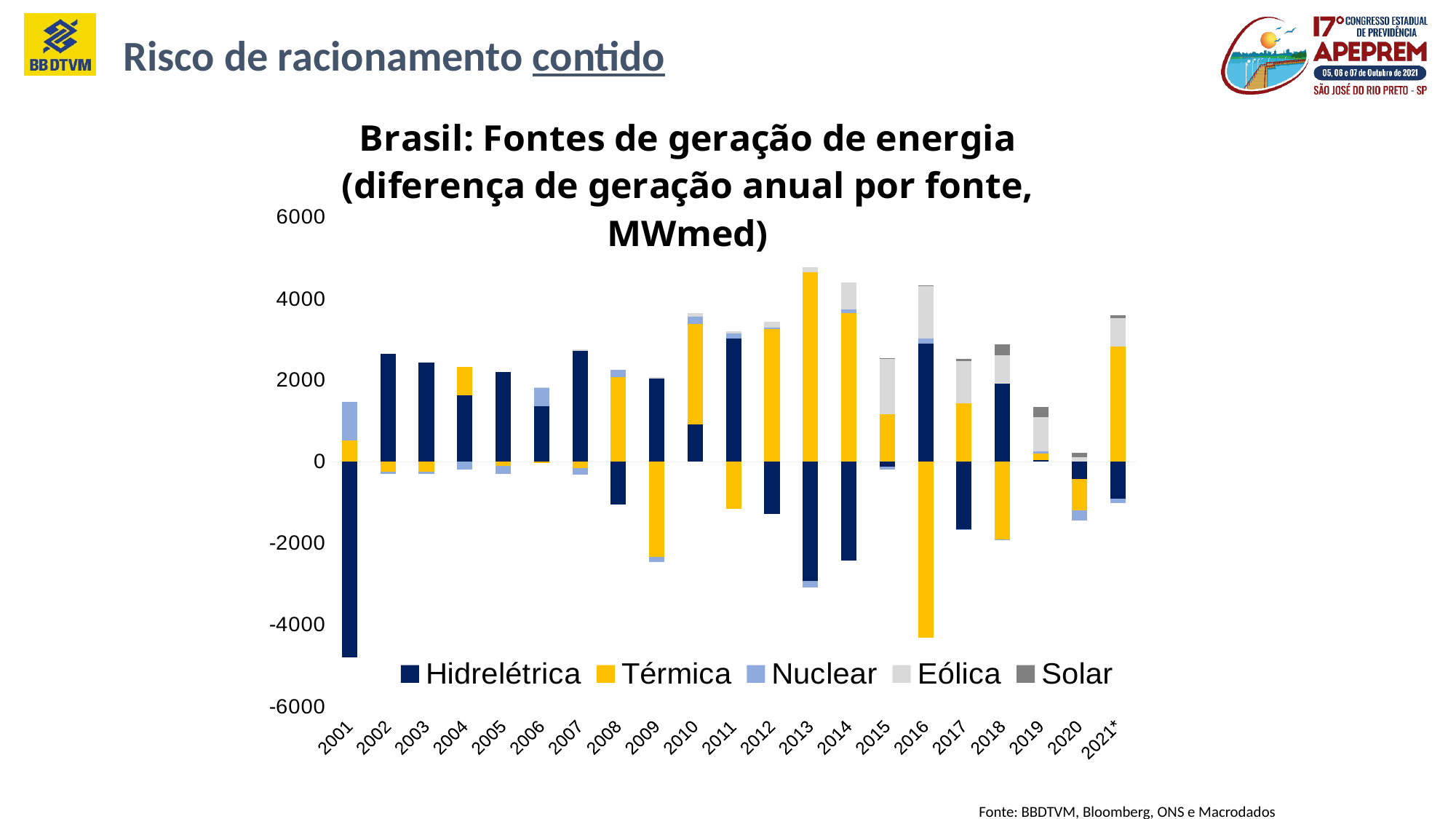
Which series is shown in dark blue in the legend? Hidrelétrica Is the Térmica value for 2013 greater or less than 4000? greater Is the Hidrelétrica value for 2002 greater or less than 2000? greater How many series does the legend list? 5 In which year is the Hidrelétrica value the lowest (most negative)? 2001 How many years are shown on the x axis? 21 Is the Hidrelétrica value for 2001 greater or less than -4000? less What kind of chart is shown on the slide? Stacked bar chart What is the title of the chart? Brasil: Fontes de geração de energia (diferença de geração anual por fonte, MWmed) Which year has the larger Hidrelétrica value, 2002 or 2006? 2002 In which year is the Térmica value the highest? 2013